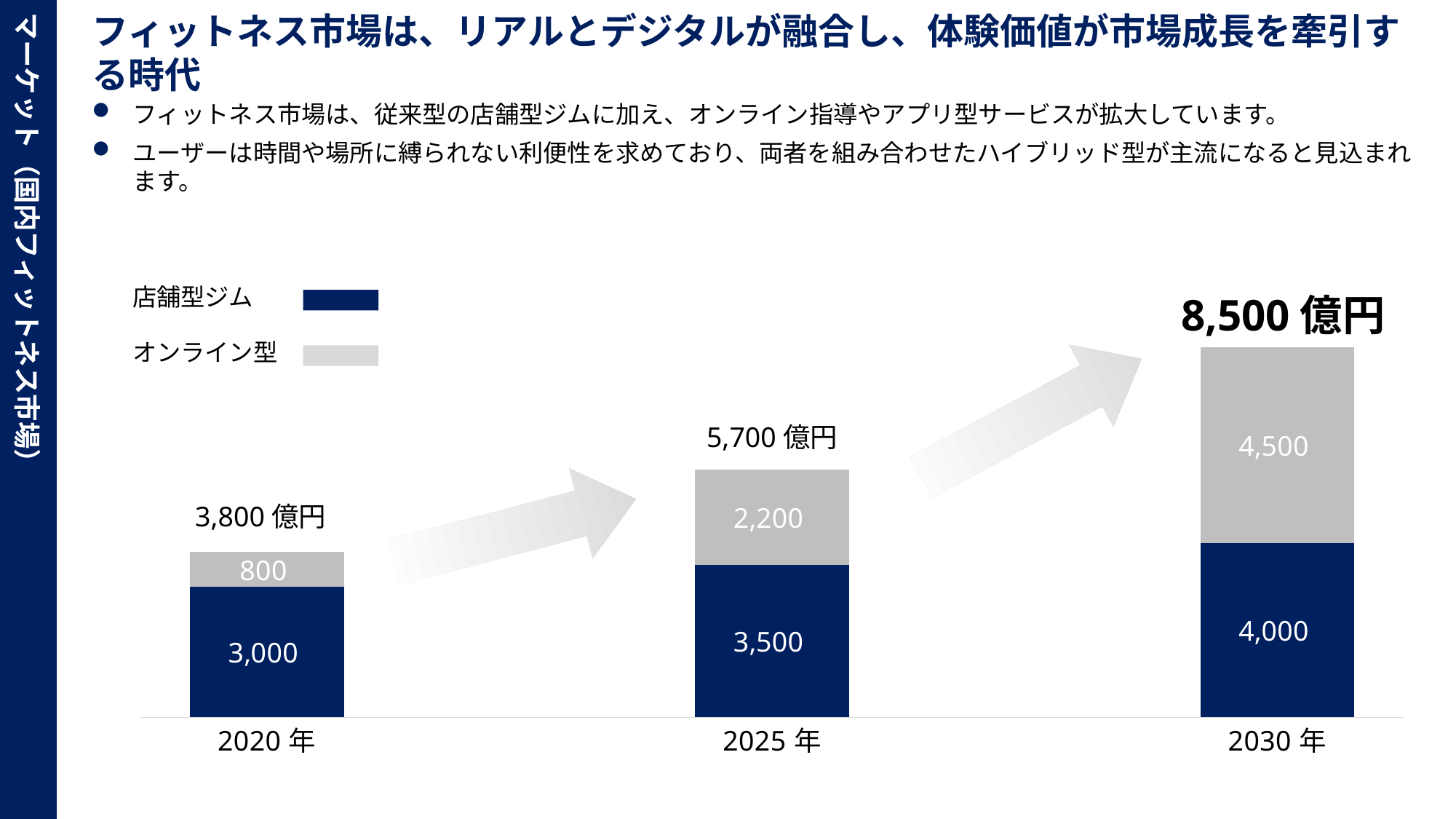
What is the value for 店舗型ジム in 2020 年? 3,000 What is the total of the stacked bar for 2030 年? 8,500 億円 What kind of chart is shown on the slide? Stacked bar chart What is the value for オンライン型 in 2025 年? 2,200 What is the total of the stacked bar for 2025 年? 5,700 億円 How many years are shown on the x axis? 3 How many series does the legend list? 2 What is the value for オンライン型 in 2030 年? 4,500 In 2030 年, which is larger: 店舗型ジム or オンライン型? オンライン型 Which year has the highest total market value? 2030 年 Which year has the lowest value for オンライン型? 2020 年 What is the difference between the 店舗型ジム values for 2030 年 and 2020 年? 1,000